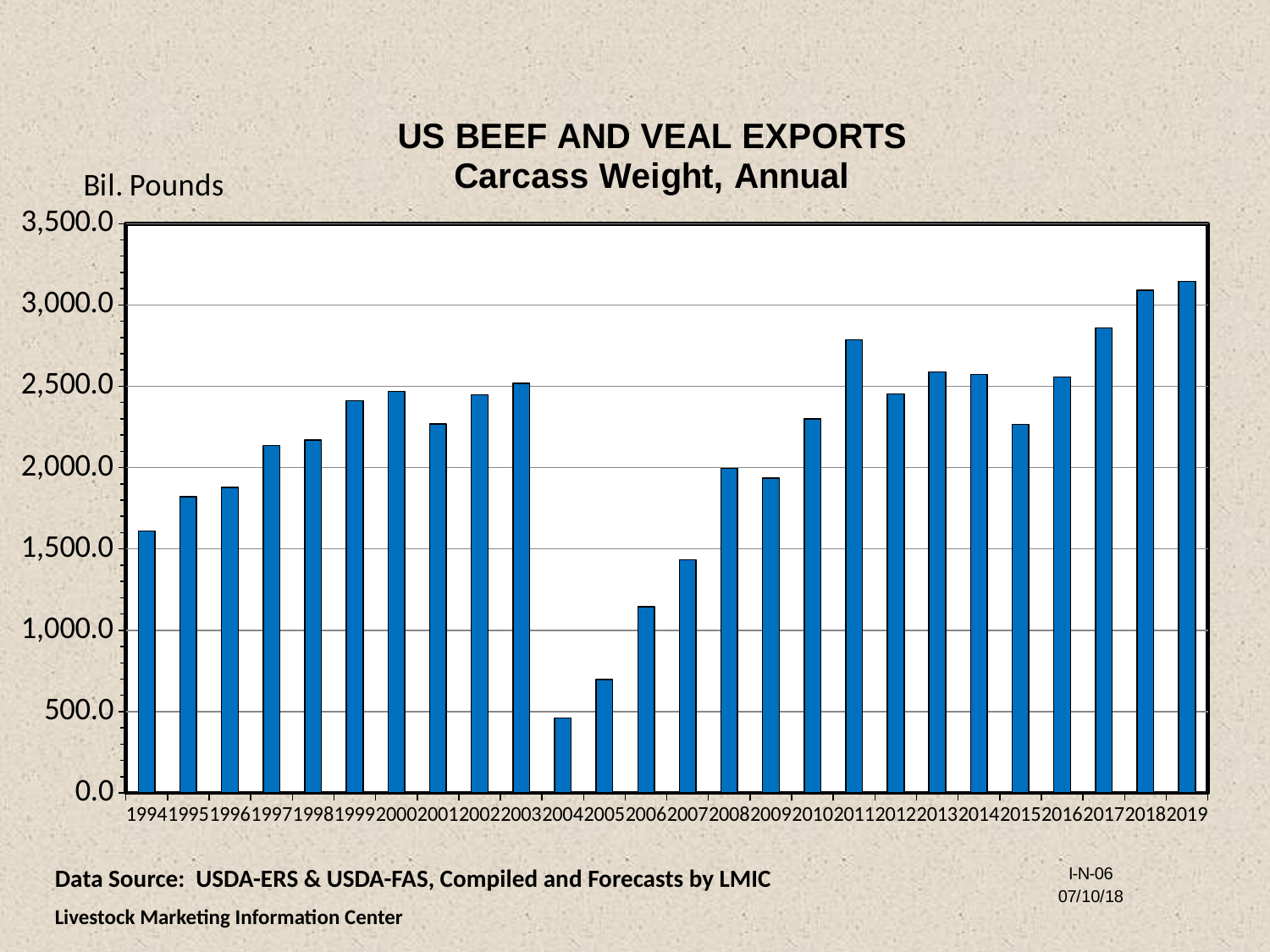
Is the value for 2007 greater or less than 1,500.0? less Is the value for 2011 greater or less than 2,500.0? greater What unit is shown on the y axis label? Bil. Pounds Do the values rise or fall from 2004 to 2008? Rise How many years are plotted on the x axis? 26 Which year has the highest value for US beef and veal exports? 2019 Is the value for 2004 greater or less than 500.0? less Which year has the larger value, 2010 or 2011? 2011 Which year has the lowest value for US beef and veal exports? 2004 What kind of chart is shown on the slide? Bar chart Which year has the larger value, 2004 or 2005? 2005